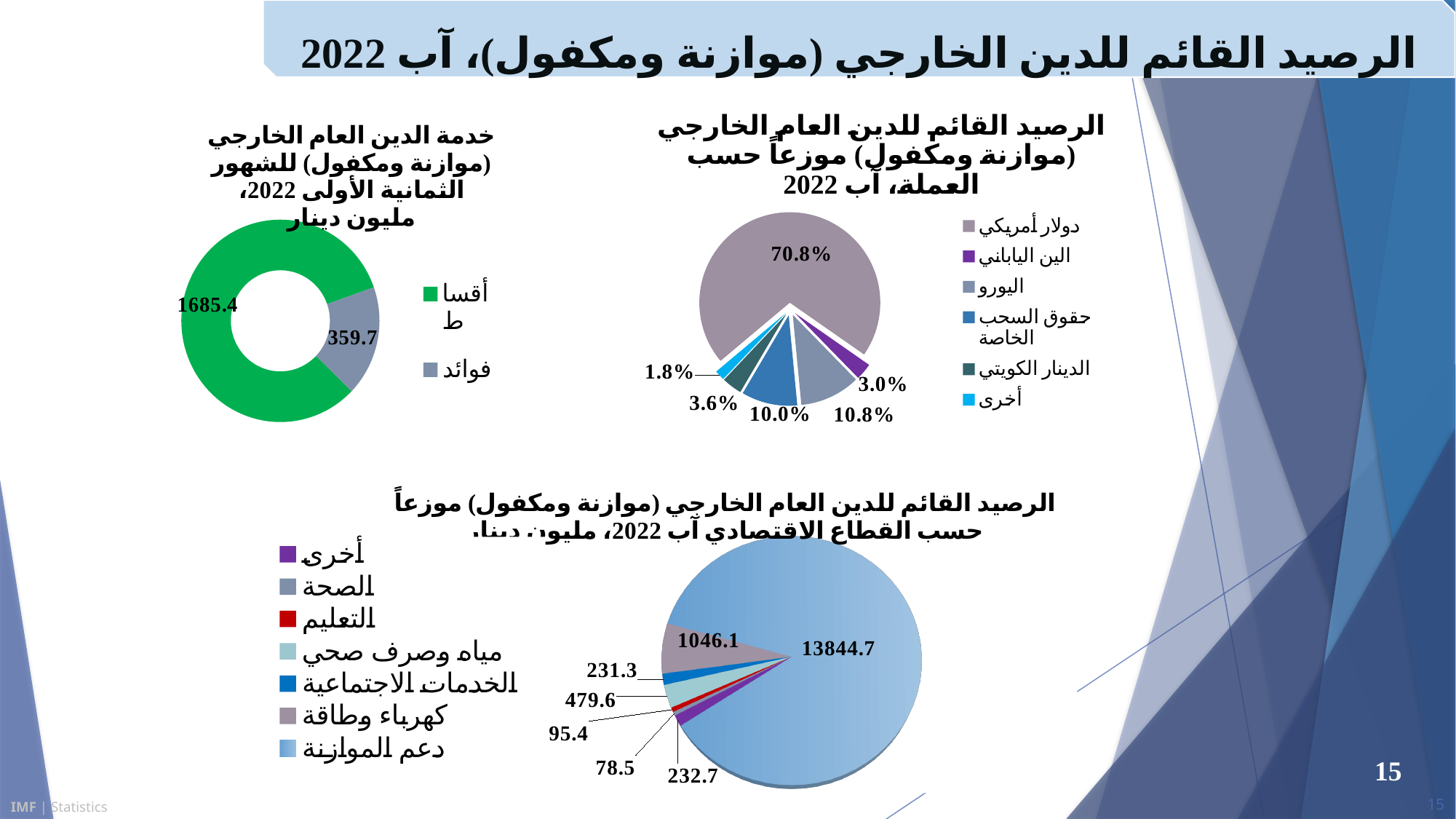
In the bottom pie chart, how many sectors does the legend list? 7 In the top-left donut chart, what is the difference between أقساط and فوائد? 1325.7 In the top-left donut chart (خدمة الدين العام الخارجي), what is the value for فوائد? 359.7 In the top-right pie chart (distribution by currency), what share does اليورو have? 10.8% In the top-right pie chart (distribution by currency), which currency has the smallest share? أخرى In the top-right pie chart, which is larger: حقوق السحب الخاصة or الدينار الكويتي? حقوق السحب الخاصة In the bottom pie chart (distribution by economic sector), what is the value for كهرباء وطاقة? 1046.1 In the top-left donut chart (خدمة الدين العام الخارجي), what is the value for أقساط? 1685.4 In the bottom pie chart (distribution by economic sector), which sector has the smallest value? الصحة In the top-left donut chart, how many categories does the legend list? 2 In the bottom pie chart (distribution by economic sector), what is the value for دعم الموازنة? 13844.7 In the top-right pie chart (distribution by currency), what share does دولار أمريكي have? 70.8%